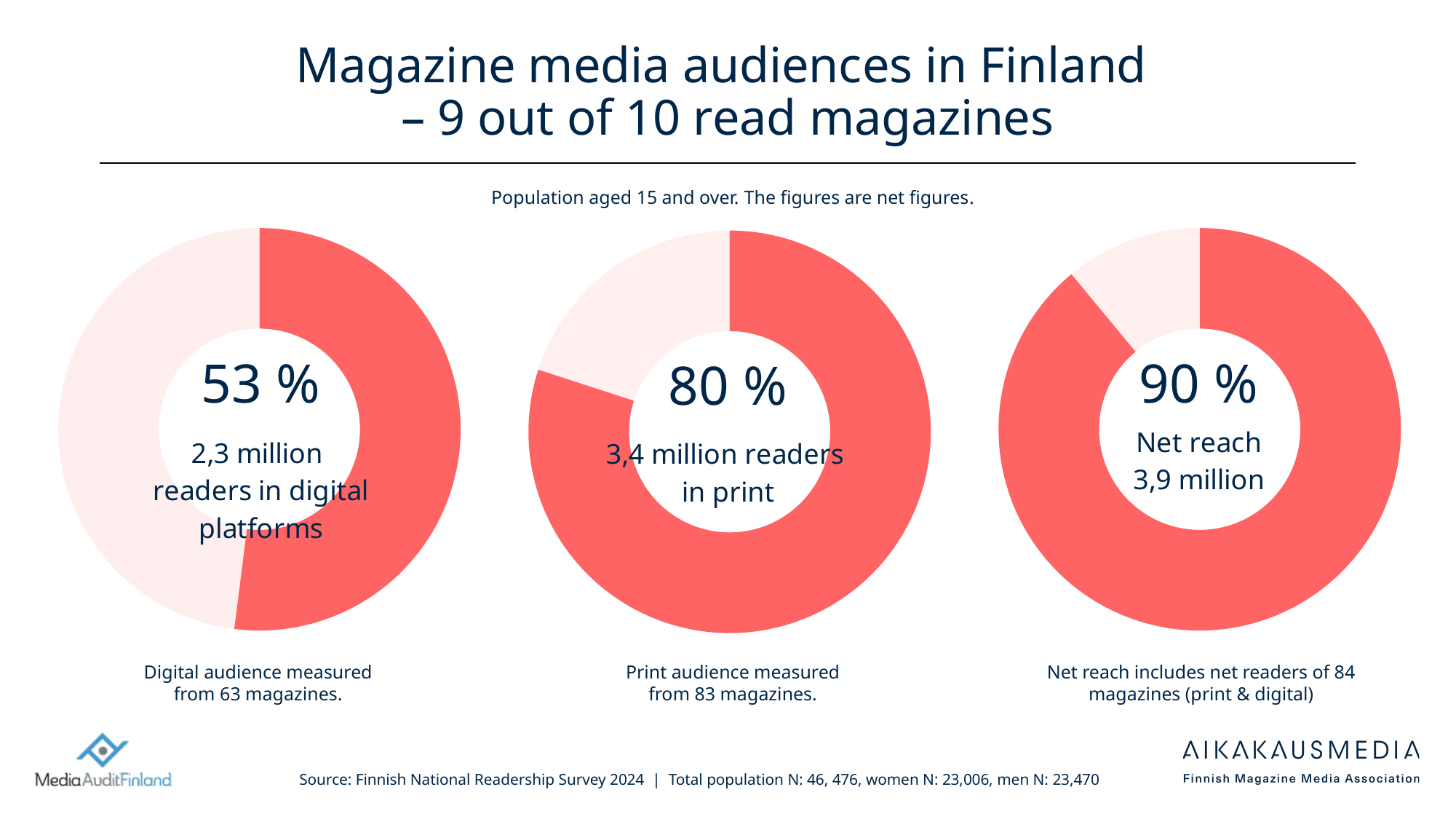
What type of chart is used to display the audience figures on this slide? Donut (pie) chart Which is larger: the print readership percentage or the digital platforms readership percentage? Print (80 %) How many donut charts are shown on the slide? 3 Which of the three donut charts shows the highest percentage? Net reach (90 %) What percentage is shown in the centre of the left donut chart (digital platforms)? 53 % What is the difference in percentage points between the print chart (80 %) and the digital platforms chart (53 %)? 27 percentage points How many million readers in print does the middle donut chart report? 3,4 million What percentage is shown in the centre of the right donut chart (net reach)? 90 % What is the net reach in millions shown in the right donut chart? 3,9 million What percentage is shown in the centre of the middle donut chart (print)? 80 % How many million readers in digital platforms does the left donut chart report? 2,3 million Which of the three donut charts shows the lowest percentage? Digital platforms (53 %)